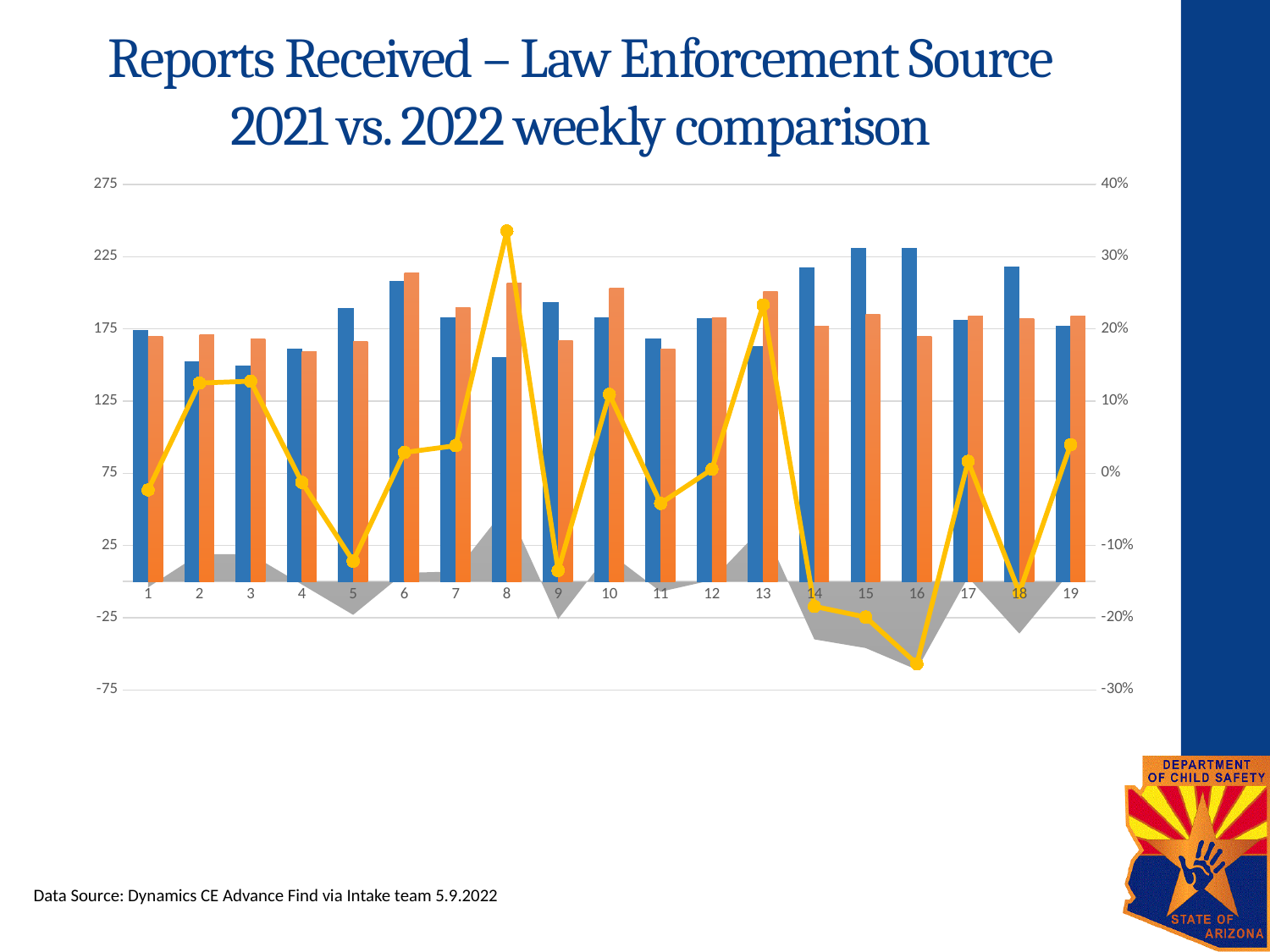
At which week does the yellow line reach its lowest point? 16 At week 8, which bar is taller, the blue bar or the orange bar? The orange bar Does the yellow line rise or fall from week 13 to week 16? Fall Is the yellow line value at week 8 greater or less than 30%? greater Is the yellow line value at week 16 greater or less than -20%? less At week 14, which bar is taller, the blue bar or the orange bar? The blue bar What kind of chart is shown on the slide? A combination bar, line and area chart What is the title of the chart on the slide? Reports Received – Law Enforcement Source 2021 vs. 2022 weekly comparison Is the blue bar at week 15 greater or less than 200? greater How many weeks are shown along the x axis of the chart? 19 At which week does the yellow line reach its highest point? 8